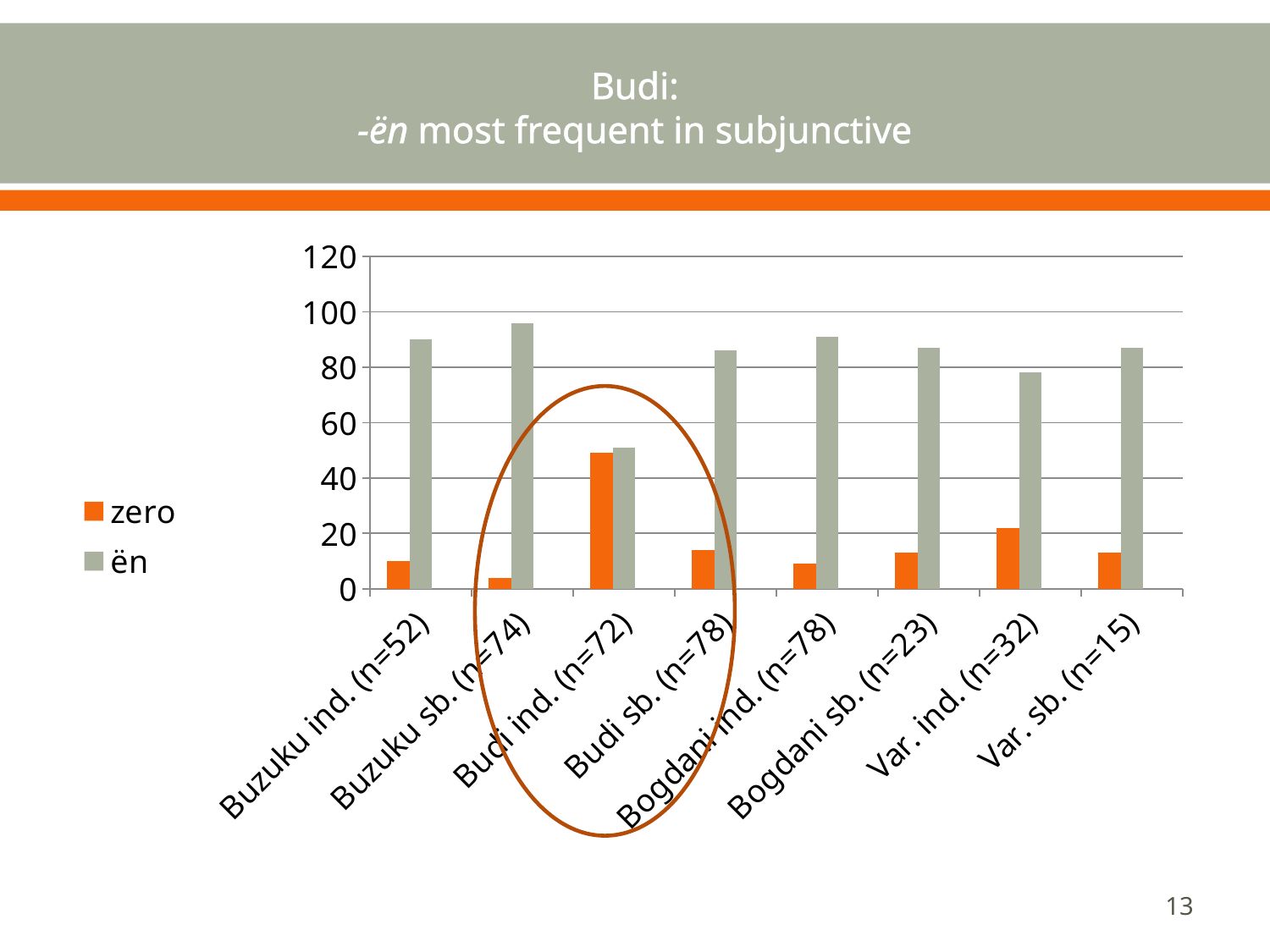
How many categories are shown on the x axis? 8 Which category has the lowest value for the zero series? Buzuku sb. (n=74) Is the ën value for Buzuku sb. (n=74) greater or less than 80? greater Is the zero value for Buzuku ind. (n=52) greater or less than 20? less Which category on the chart is circled? Budi ind. (n=72) Is the ën value for Budi ind. (n=72) greater or less than 60? less What kind of chart is shown on the slide? bar chart How many series does the legend list? 2 Which category has the highest value for the zero series? Budi ind. (n=72) Which is larger, the ën value for Buzuku ind. (n=52) or the ën value for Var. ind. (n=32)? Buzuku ind. (n=52) Which category has the lowest value for the ën series? Budi ind. (n=72)